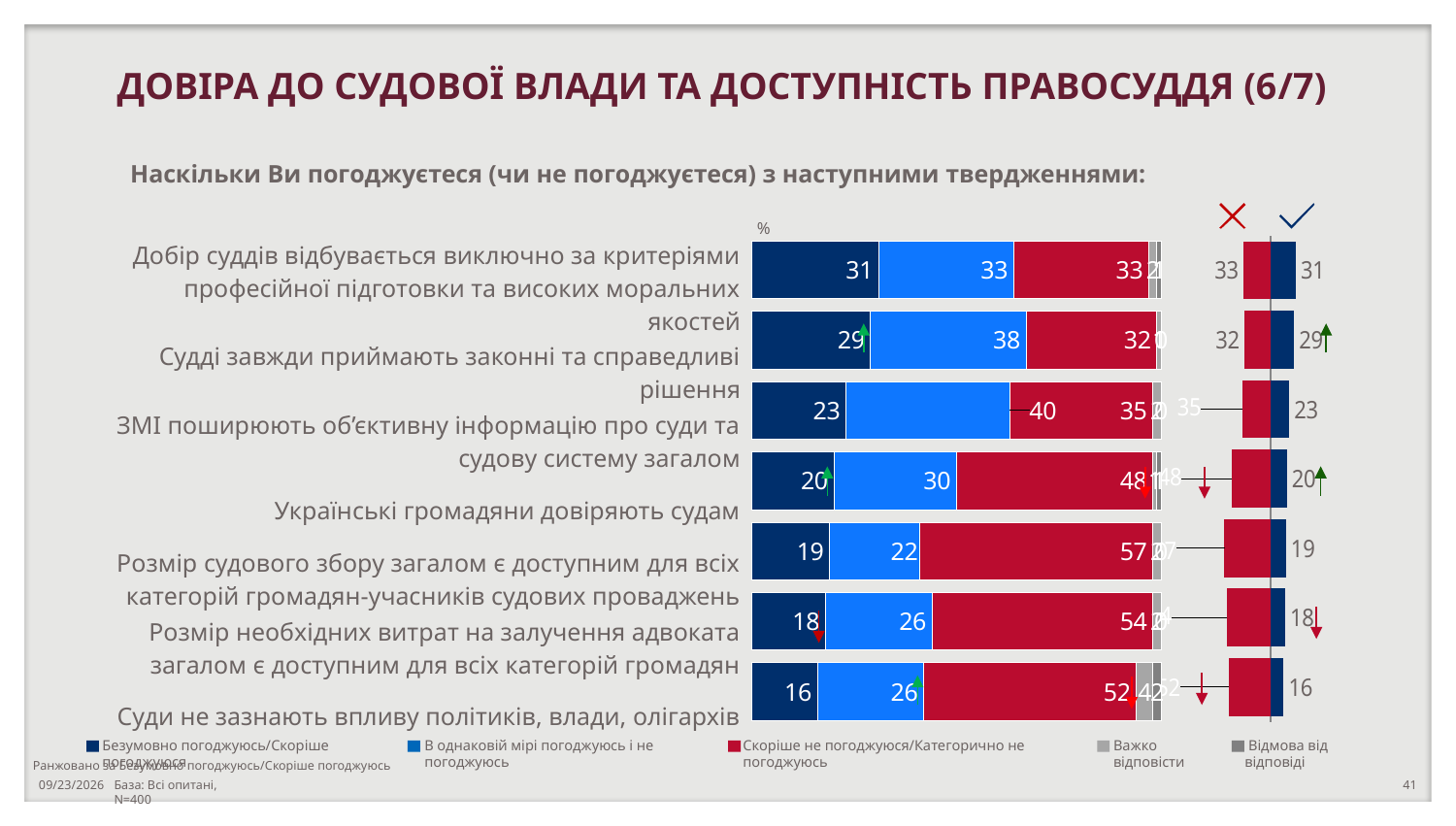
Which is larger: the 'В однаковій мірі погоджуюсь і не погоджуюсь' value for 'Судді завжди приймають законні та справедливі рішення' or for 'Українські громадяни довіряють судам'? Судді завжди приймають законні та справедливі рішення Which statement has the lowest value for 'Безумовно погоджуюсь/Скоріше погоджуюсь'? Суди не зазнають впливу політиків, влади, олігархів What is the value of 'Безумовно погоджуюсь/Скоріше погоджуюсь' for the statement 'Українські громадяни довіряють судам'? 20 What is the value of 'В однаковій мірі погоджуюсь і не погоджуюсь' for the statement 'ЗМІ поширюють об’єктивну інформацію про суди та судову систему загалом'? 40 How many statements (categories) are plotted in the chart? 7 How many series does the legend list? 5 Which statement has the highest value for 'Безумовно погоджуюсь/Скоріше погоджуюсь'? Добір суддів відбувається виключно за критеріями професійної підготовки та високих моральних якостей What kind of chart is shown on the slide? stacked bar chart What is the value of 'Скоріше не погоджуюся/Категорично не погоджуюсь' for the statement 'Розмір судового збору загалом є доступним для всіх категорій громадян-учасників судових проваджень'? 57 What is the difference between the 'Скоріше не погоджуюся/Категорично не погоджуюсь' values for 'Українські громадяни довіряють судам' and 'Судді завжди приймають законні та справедливі рішення'? 16 Do the 'Безумовно погоджуюсь/Скоріше погоджуюсь' values rise or fall going from the top statement to the bottom statement? fall Which statement has the highest value for 'Скоріше не погоджуюся/Категорично не погоджуюсь'? Розмір судового збору загалом є доступним для всіх категорій громадян-учасників судових проваджень